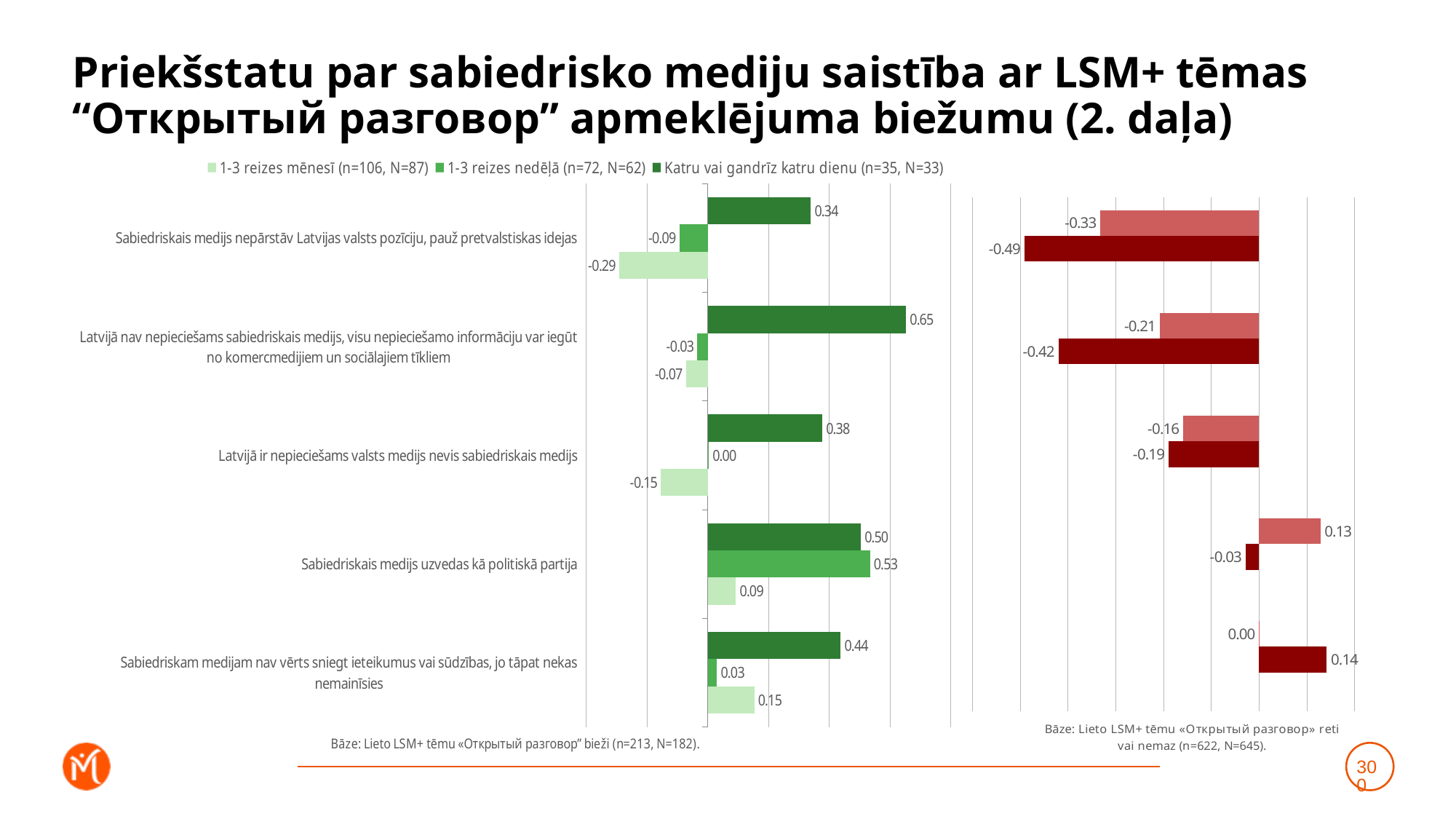
How many series does the legend of the left (green) chart list? 3 In the left (green) chart, what is the value for "1-3 reizes mēnesī" for "Sabiedriskais medijs nepārstāv Latvijas valsts pozīciju, pauž pretvalstiskas idejas"? -0.29 How many categories are shown in the left (green) chart? 5 In the left (green) chart, what is the value for "1-3 reizes nedēļā" for "Sabiedriskais medijs uzvedas kā politiskā partija"? 0.53 In the right (red) chart, what is the value of the lighter red bar for "Sabiedriskais medijs uzvedas kā politiskā partija"? 0.13 What type of chart is the left (green) chart? Bar chart In the right (red) chart, what is the value of the dark red bar for "Sabiedriskais medijs nepārstāv Latvijas valsts pozīciju, pauž pretvalstiskas idejas"? -0.49 In the left (green) chart, what is the value for "Katru vai gandrīz katru dienu" for "Latvijā nav nepieciešams sabiedriskais medijs, visu nepieciešamo informāciju var iegūt no komercmedijiem un sociālajiem tīkliem"? 0.65 In the left (green) chart, which category has the lowest value for "1-3 reizes mēnesī"? Sabiedriskais medijs nepārstāv Latvijas valsts pozīciju, pauž pretvalstiskas idejas In the left (green) chart, for "Sabiedriskais medijs uzvedas kā politiskā partija", which is larger: the "1-3 reizes nedēļā" value or the "Katru vai gandrīz katru dienu" value? 1-3 reizes nedēļā In the left (green) chart, which category has the highest value for "Katru vai gandrīz katru dienu"? Latvijā nav nepieciešams sabiedriskais medijs, visu nepieciešamo informāciju var iegūt no komercmedijiem un sociālajiem tīkliem In the left (green) chart, what is the difference between the "Katru vai gandrīz katru dienu" value (0.34) and the "1-3 reizes mēnesī" value (-0.29) for "Sabiedriskais medijs nepārstāv Latvijas valsts pozīciju, pauž pretvalstiskas idejas"? 0.63